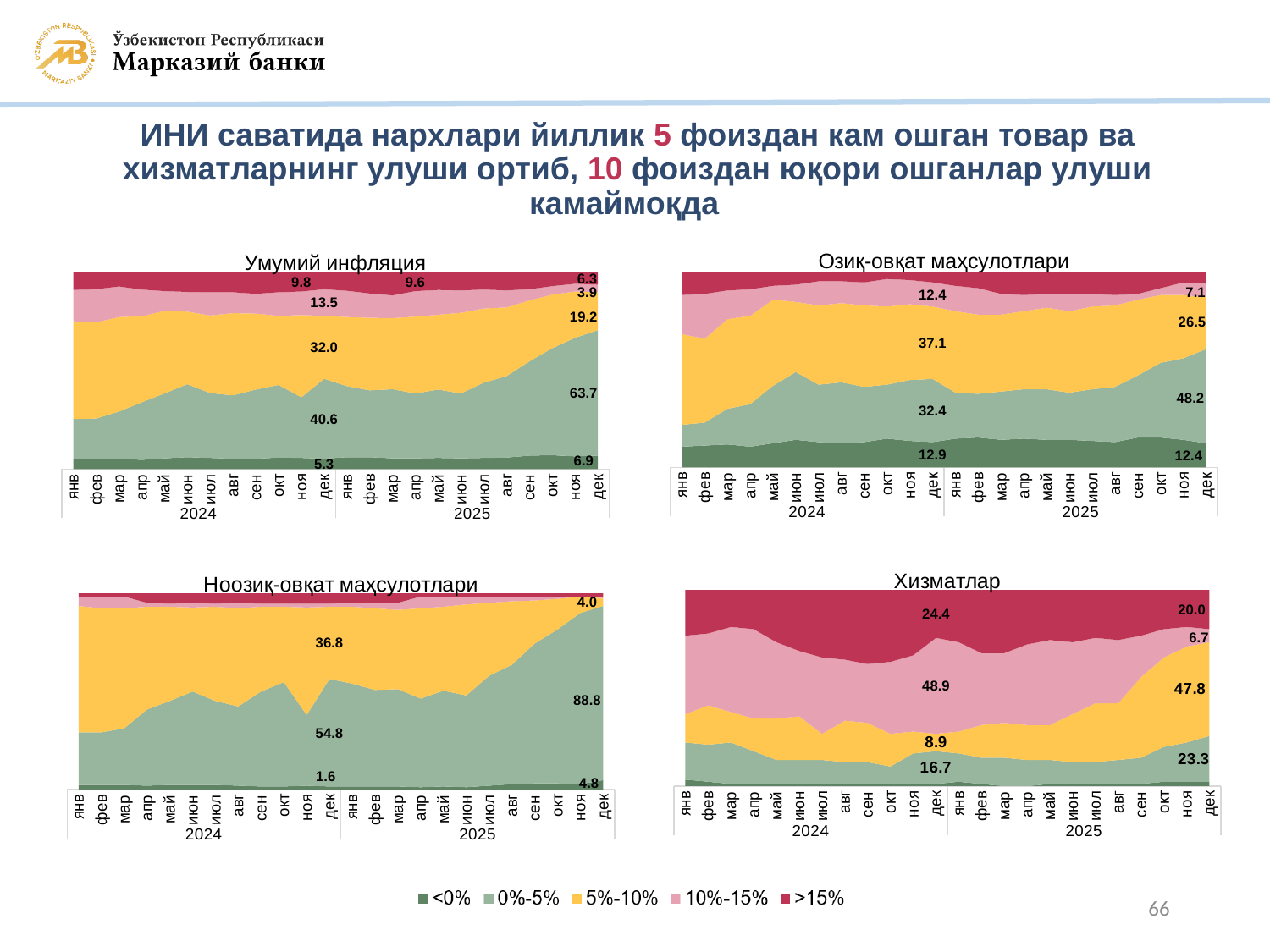
Which colour represents the >15% series in the legend? dark red In the 'Озиқ-овқат маҳсулотлари' chart, which is larger: the 5%-10% value labelled for 2024 or the 5%-10% value at дек 2025? 2024 (37.1) In the 'Умумий инфляция' chart, what is the value of the 5%-10% series labelled for 2024? 32.0 How many series does the legend list? 5 In the 'Умумий инфляция' chart, by how much did the 0%-5% series change from the 2024 label (40.6) to the 2025 дек label (63.7)? 23.1 In the 'Хизматлар' chart, what is the value of the >15% series at the end of 2025 (дек)? 20.0 In the 'Ноозиқ-овқат маҳсулотлари' chart, what is the value of the 0%-5% series at the end of 2025 (дек)? 88.8 In the 'Озиқ-овқат маҳсулотлари' chart, what is the value of the 0%-5% series at the end of 2025 (дек)? 48.2 What kind of chart is 'Ноозиқ-овқат маҳсулотлари'? stacked area chart In the 'Умумий инфляция' chart, what is the value of the 0%-5% series at the end of 2025 (дек)? 63.7 In the 'Хизматлар' chart, what is the value of the 10%-15% series labelled for 2024? 48.9 In the 'Хизматлар' chart, does the 10%-15% series rise or fall from the 2024 label to the дек 2025 label? fall